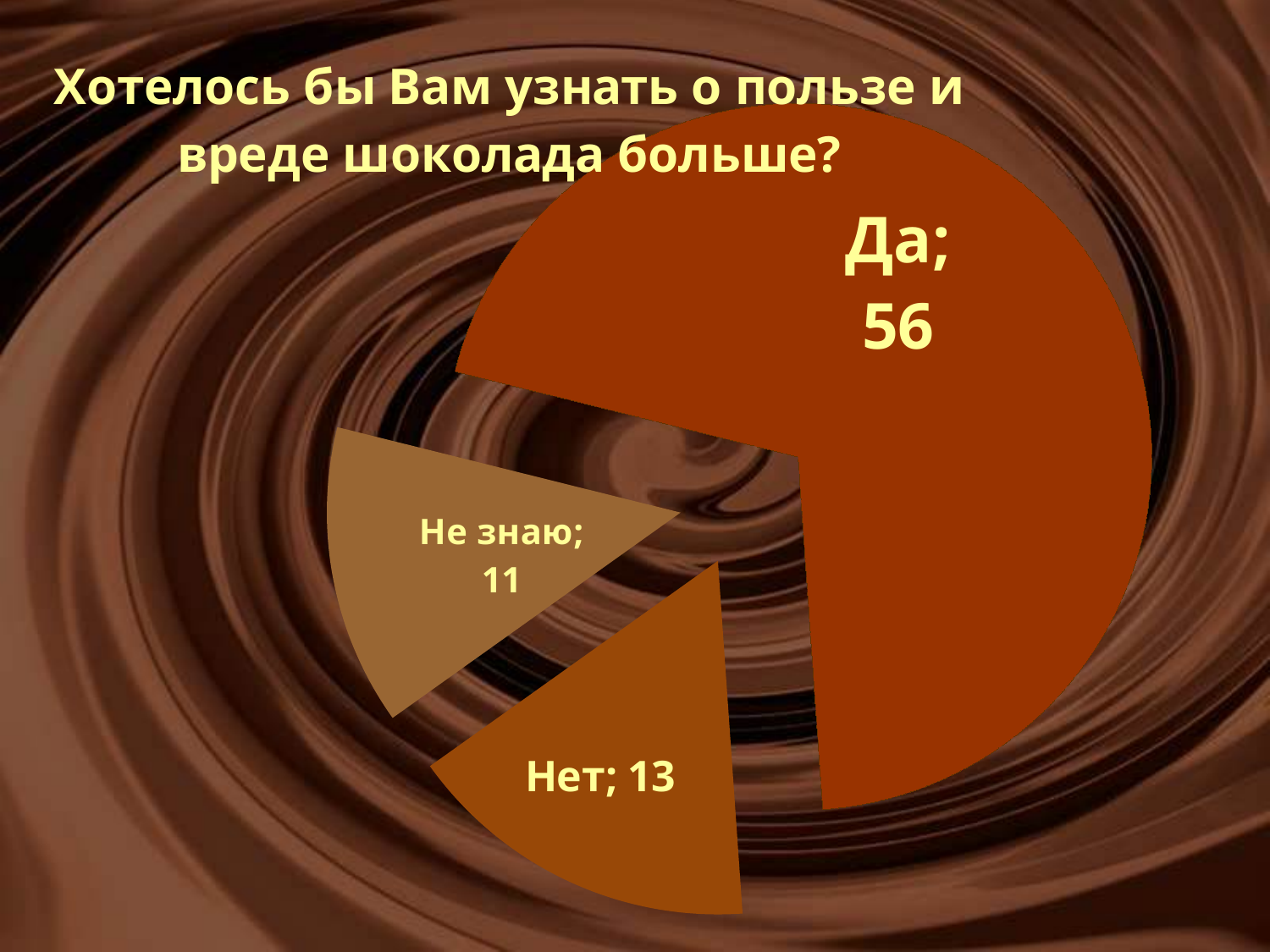
What is the difference between the values for "Да" and "Нет"? 43 Which category has the largest slice? Да What is the value for the "Да" slice? 56 What is the difference between the values for "Нет" and "Не знаю"? 2 Which category has the smallest slice? Не знаю Which is larger, the value for "Нет" or the value for "Не знаю"? Нет What is the value for the "Не знаю" slice? 11 What is the value for the "Нет" slice? 13 How many slices does the pie chart have? 3 What is the title of the chart? Хотелось бы Вам узнать о пользе и вреде шоколада больше? What share of the pie does the "Да" slice represent? 70% What kind of chart is shown on the slide? Pie chart